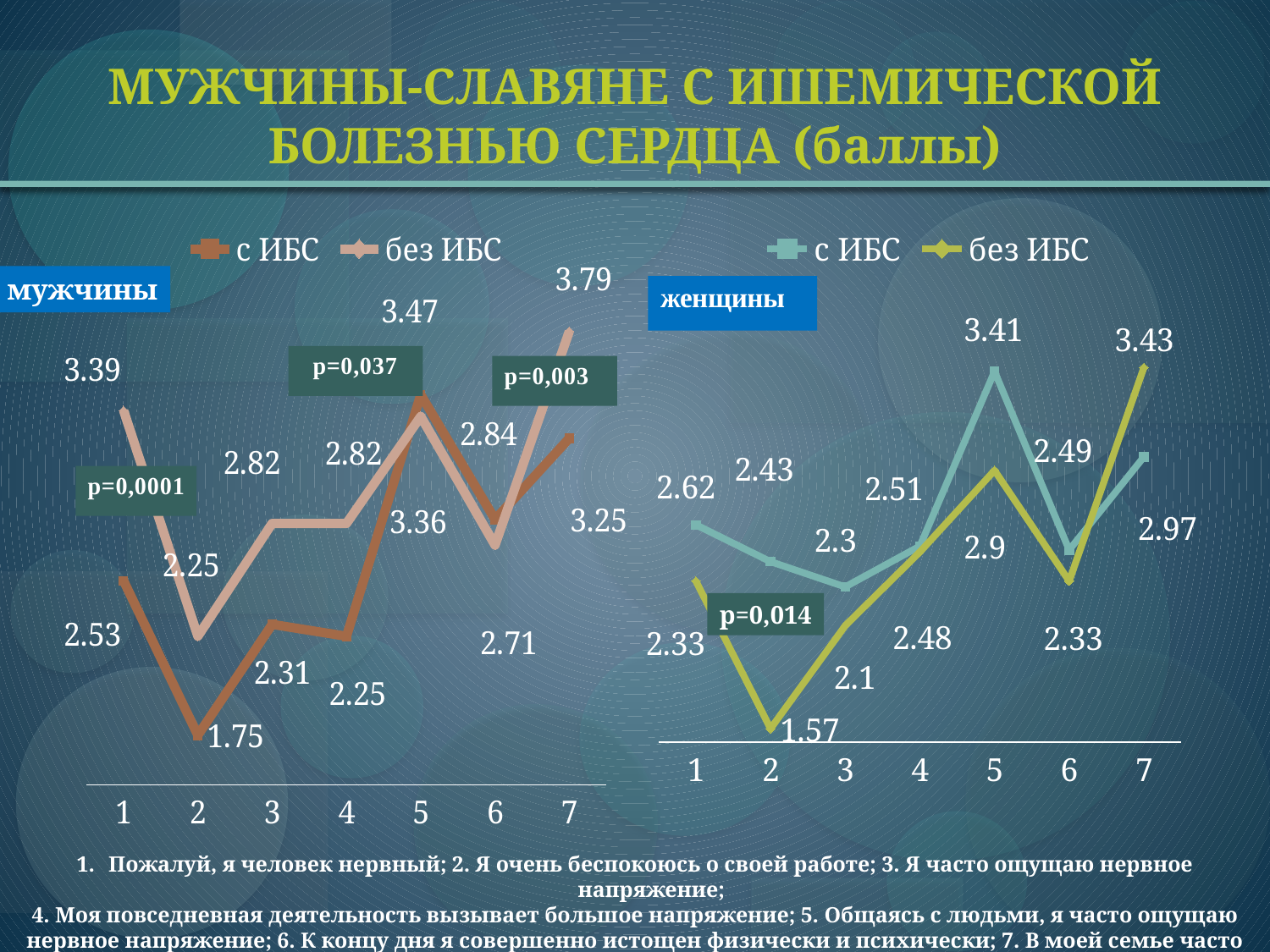
How many series does the legend of the right chart (женщины) list? 2 In the left chart (мужчины), what is the value of the 'с ИБС' series at category 2? 1.75 In the left chart (мужчины), what is the difference between the 'без ИБС' and 'с ИБС' values at category 1? 0.86 In the right chart (женщины), which series has the larger value at category 7, 'с ИБС' or 'без ИБС'? без ИБС In the right chart (женщины), which category has the highest value for the 'с ИБС' series? 5 In the left chart (мужчины), which category has the lowest value for the 'с ИБС' series? 2 What p-value is shown in the box on the right chart (женщины)? p=0,014 What kind of chart is the left chart (мужчины)? line chart In the right chart (женщины), what is the difference between the 'с ИБС' and 'без ИБС' values at category 5? 0.51 In the left chart (мужчины), what is the value of the 'без ИБС' series at category 7? 3.79 In the right chart (женщины), what is the value of the 'без ИБС' series at category 2? 1.57 How many categories are shown on the x axis of the left chart (мужчины)? 7